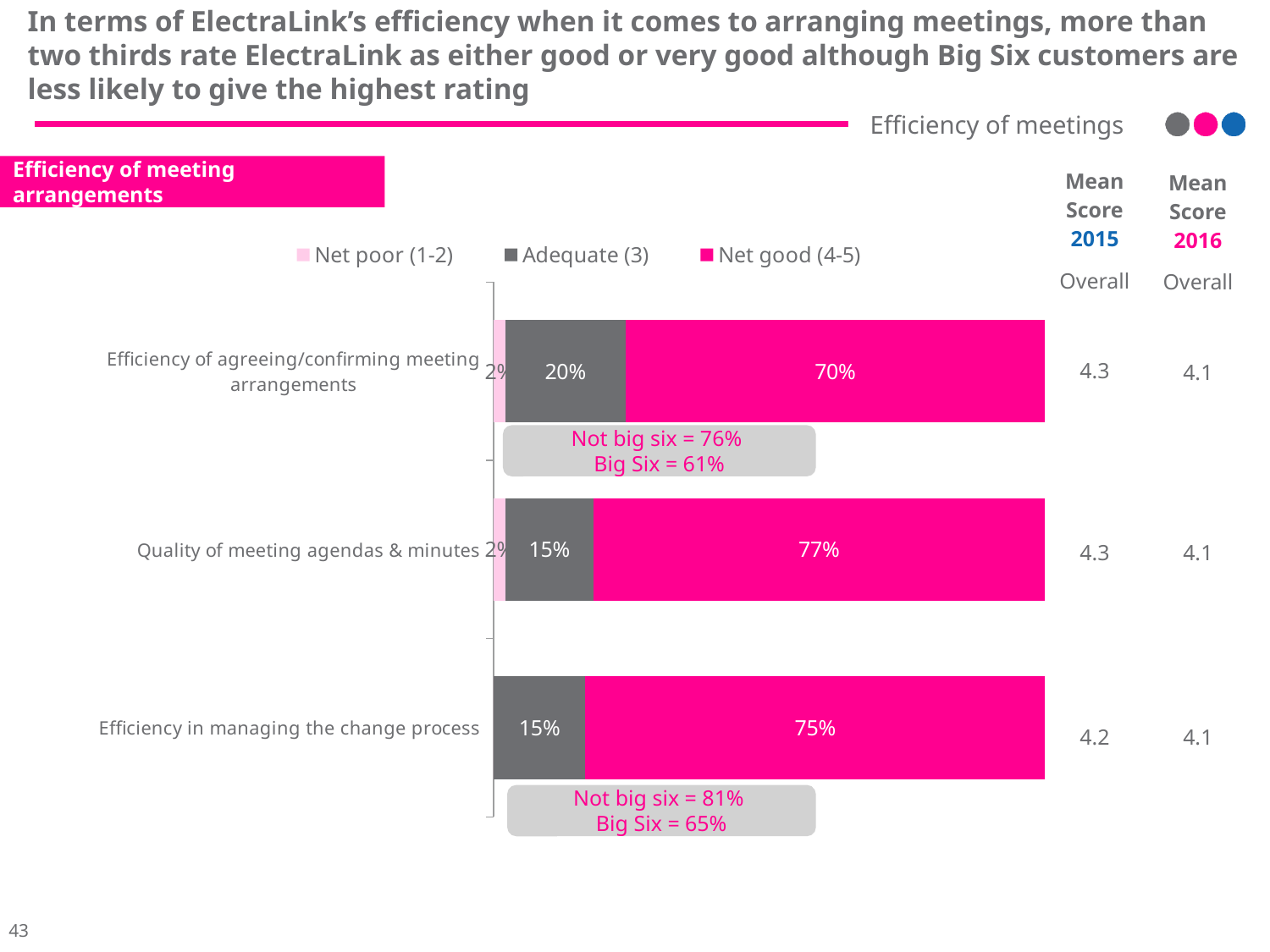
Which category has the highest Net good (4-5) value? Quality of meeting agendas & minutes What is the Adequate (3) value for Quality of meeting agendas & minutes? 15% What is the Net good (4-5) value for Efficiency in managing the change process? 75% How many categories are plotted in the chart? 3 Which category has the lowest Net good (4-5) value? Efficiency of agreeing/confirming meeting arrangements What is the Adequate (3) value for Efficiency of agreeing/confirming meeting arrangements? 20% Which has the larger Adequate (3) value: Efficiency of agreeing/confirming meeting arrangements or Efficiency in managing the change process? Efficiency of agreeing/confirming meeting arrangements What is the Net good (4-5) value for Quality of meeting agendas & minutes? 77% How many series does the chart legend list? 3 What is the difference between the Net good (4-5) values for Quality of meeting agendas & minutes and Efficiency of agreeing/confirming meeting arrangements? 7 percentage points What colour represents the Net good (4-5) series in the chart? Pink What kind of chart is shown on the slide? Stacked bar chart